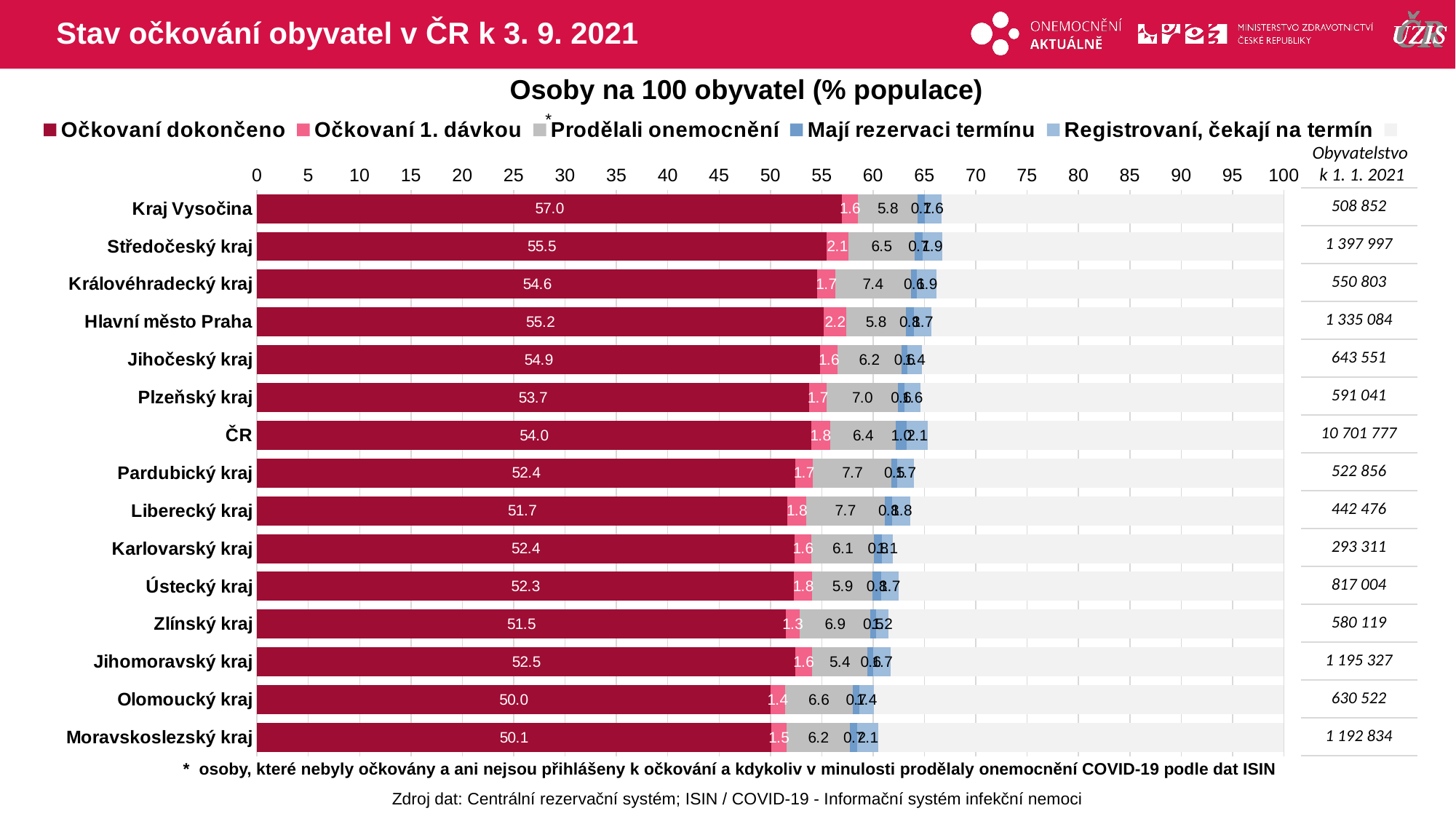
Which region has the highest value of Očkovaní dokončeno? Kraj Vysočina Is the Očkovaní dokončeno value for Zlínský kraj greater or less than 55? less What is the value of Očkovaní dokončeno for ČR? 54.0 Which has a larger Očkovaní dokončeno value, Středočeský kraj or Plzeňský kraj? Středočeský kraj Which region has the lowest value of Očkovaní dokončeno? Olomoucký kraj What type of chart is shown on the slide? stacked bar chart What is the difference in Očkovaní dokončeno between Kraj Vysočina and Olomoucký kraj? 7.0 How many regions (categories) are plotted in the chart? 15 What is the value of Očkovaní dokončeno for Kraj Vysočina? 57.0 What is the value of Očkovaní 1. dávkou for Hlavní město Praha? 2.2 What is the value of Prodělali onemocnění for Královéhradecký kraj? 7.4 What is the title of the chart? Osoby na 100 obyvatel (% populace)